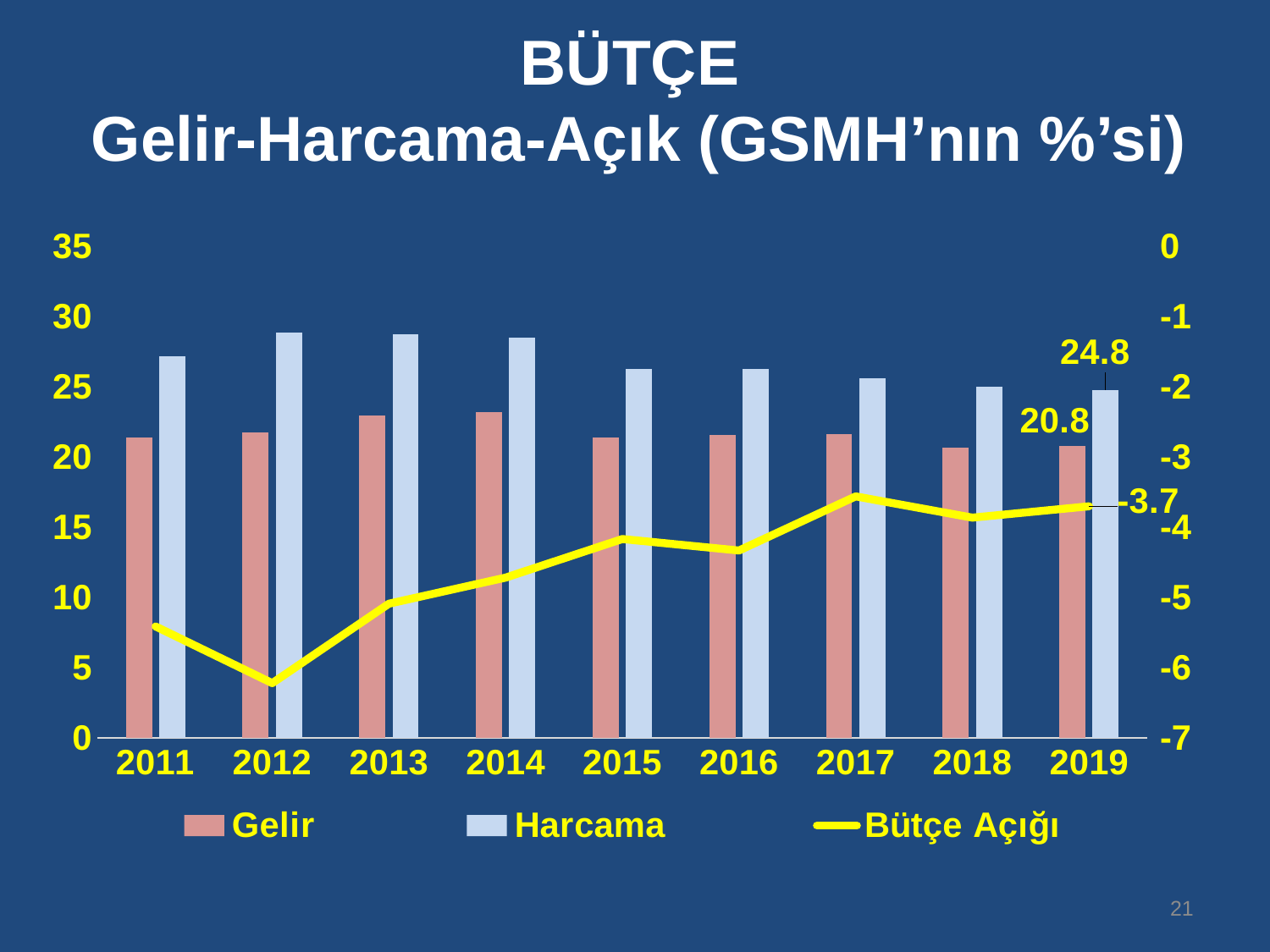
Which is larger, Harcama in 2012 or Harcama in 2019? Harcama in 2012 What is the value of Harcama for 2019? 24.8 In which year is Bütçe Açığı at its lowest (most negative) value? 2012 Is the value of Harcama for 2012 greater or less than 25? greater Is the value of Bütçe Açığı for 2012 greater or less than -5? less How many series does the legend list? 3 What kind of chart is this? Combined bar and line chart What is the value of Bütçe Açığı for 2019? -3.7 How many years are shown on the x axis? 9 What is the value of Gelir for 2019? 20.8 Does the Bütçe Açığı line rise or fall from 2012 to 2017? Rises What is the difference between Harcama and Gelir in 2019? 4.0